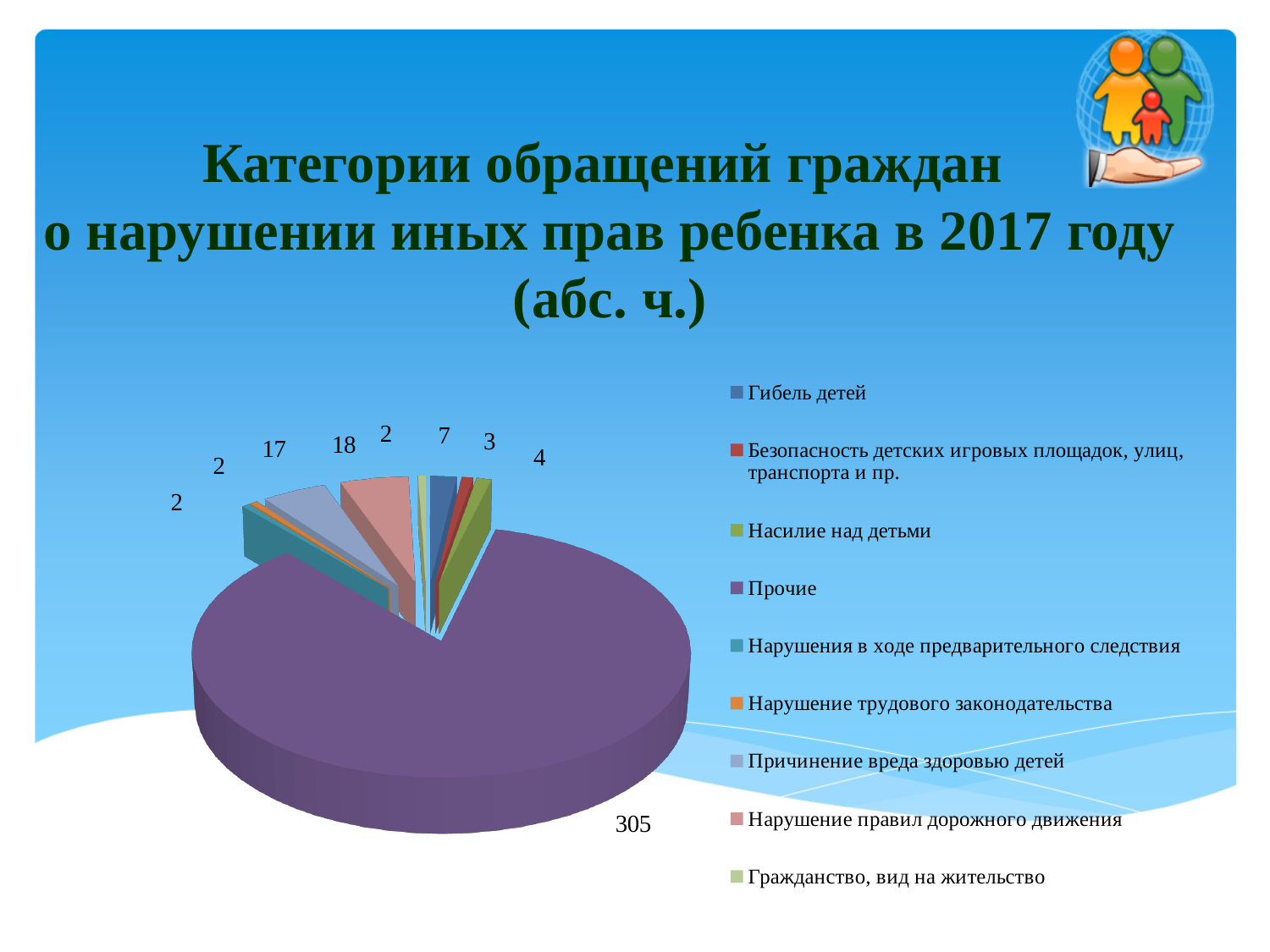
What is the value for "Безопасность детских игровых площадок, улиц, транспорта и пр."? 3 Which is larger: the value for "Гибель детей" or the value for "Насилие над детьми"? Гибель детей What is the value for "Нарушение правил дорожного движения"? 18 What is the value for "Насилие над детьми"? 4 What is the difference between the values for "Нарушение правил дорожного движения" and "Причинение вреда здоровью детей"? 1 What is the value for the category "Прочие"? 305 What is the value for "Причинение вреда здоровью детей"? 17 How many categories does the legend list? 9 Which category has the largest slice of the pie? Прочие What is the value for "Гибель детей"? 7 What year does the chart title refer to? 2017 What kind of chart is shown on the slide? pie chart